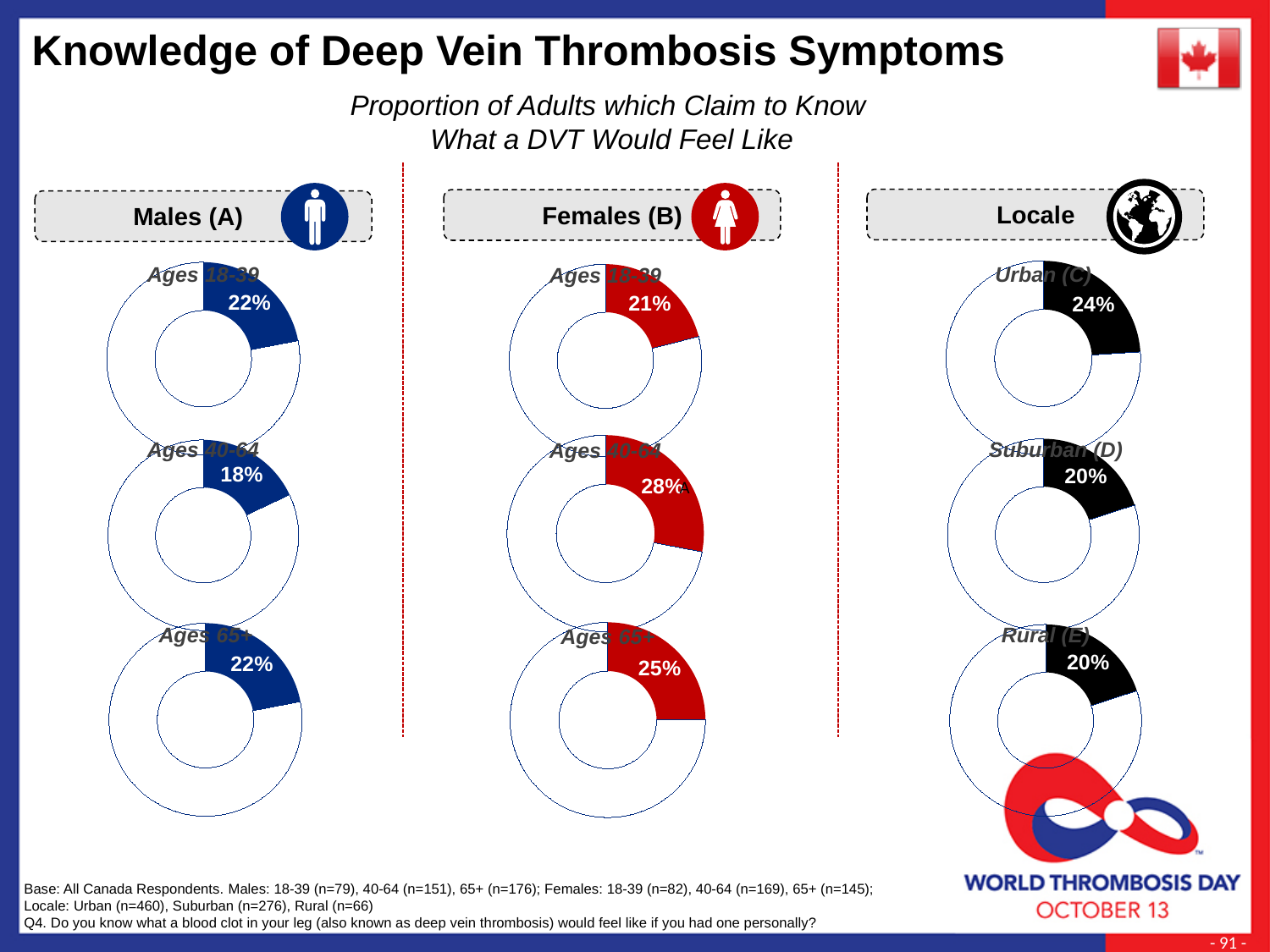
Among the three Males (A) donut charts, which age group has the lowest value? Ages 40-64 In the Locale column, what is the value shown for Rural (E)? 20% What is the difference between the Females (B) Ages 40-64 value and the Males (A) Ages 40-64 value? 10% Which is larger: the Females (B) Ages 65+ value or the Males (A) Ages 65+ value? Females (B) Ages 65+ What kind of chart is used to show each proportion on this slide? Donut chart How many donut charts are shown on the slide in total? 9 In the Females (B) column, what is the value shown for Ages 40-64? 28% In the Males (A) column, what proportion of adults aged 18-39 claim to know what a DVT would feel like? 22% In the Females (B) column, what is the value shown for Ages 65+? 25% Among the three Females (B) donut charts, which age group has the highest value? Ages 40-64 In the Locale column, what is the value shown for Urban (C)? 24% In the Males (A) column, what is the value shown for Ages 40-64? 18%